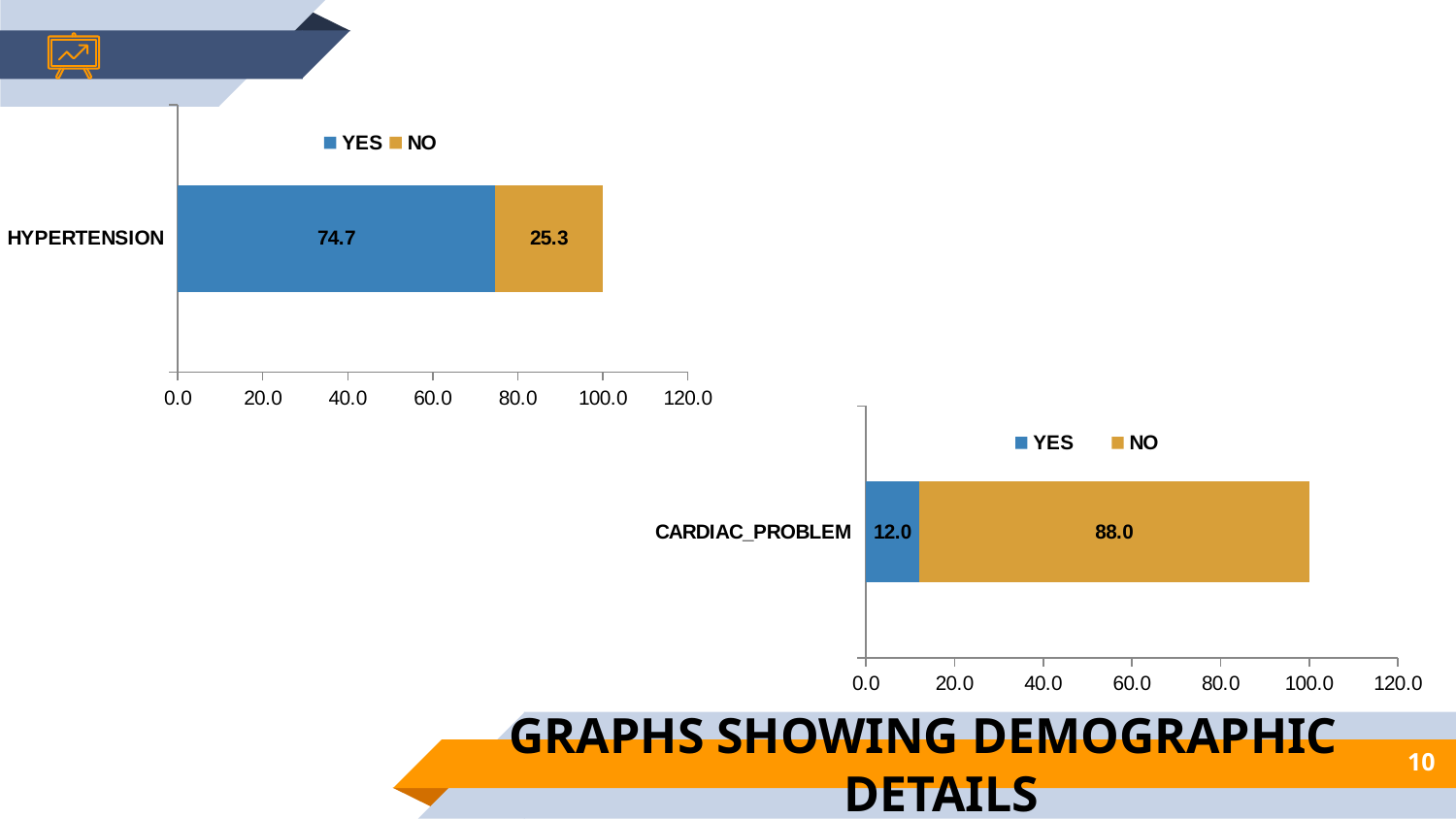
In the CARDIAC_PROBLEM chart on the right, what is the total of the stacked bar? 100.0 In the CARDIAC_PROBLEM chart on the right, what is the difference between the NO and YES values? 76.0 In the CARDIAC_PROBLEM chart on the right, which series has the larger value, YES or NO? NO What kind of chart is the HYPERTENSION chart on the left? Stacked bar chart In the HYPERTENSION chart on the left, what is the value for YES? 74.7 In the HYPERTENSION chart on the left, which series has the larger value, YES or NO? YES In the HYPERTENSION chart on the left, what is the total of the stacked bar? 100.0 In the CARDIAC_PROBLEM chart on the right, what is the value for NO? 88.0 How many series does the legend of the CARDIAC_PROBLEM chart on the right list? 2 In the HYPERTENSION chart on the left, what is the value for NO? 25.3 In the CARDIAC_PROBLEM chart on the right, what is the value for YES? 12.0 In the HYPERTENSION chart on the left, what is the difference between the YES and NO values? 49.4